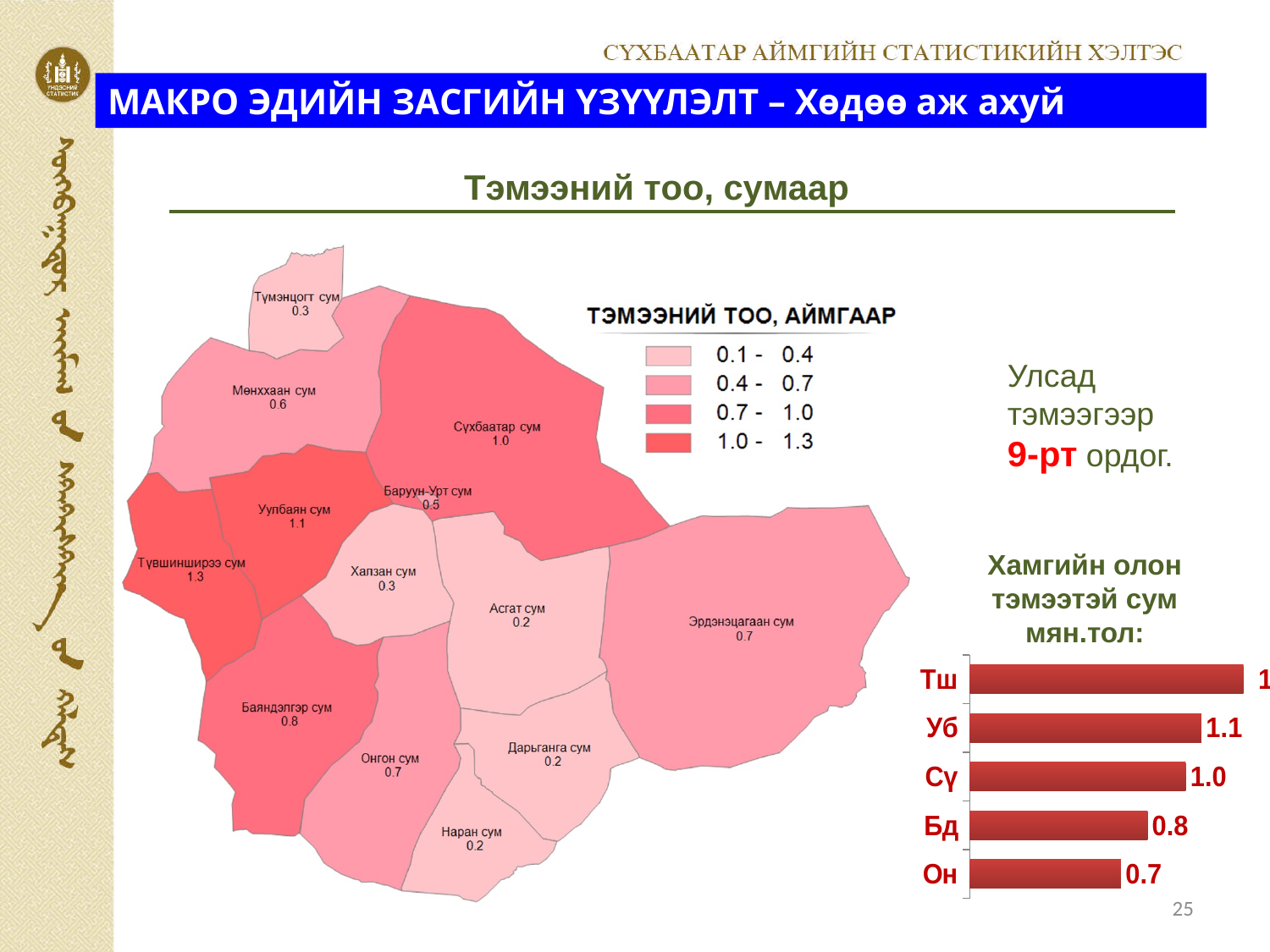
On the map 'Тэмээний тоо, сумаар', what value is printed for Түвшиншир сум? 1.3 In the bar chart 'Хамгийн олон тэмээтэй сум мян.тол:', what is the value for Уб? 1.1 In the bar chart 'Хамгийн олон тэмээтэй сум мян.тол:', what is the difference between the values for Уб and Он? 0.4 On the map 'Тэмээний тоо, сумаар', how many ranges does the legend 'ТЭМЭЭНИЙ ТОО, АЙМГААР' list? 4 In the bar chart 'Хамгийн олон тэмээтэй сум мян.тол:', which is larger, the value for Сү or the value for Бд? Сү In the bar chart 'Хамгийн олон тэмээтэй сум мян.тол:', what is the value for Бд? 0.8 In the bar chart 'Хамгийн олон тэмээтэй сум мян.тол:', what is the value for Он? 0.7 What kind of chart is 'Хамгийн олон тэмээтэй сум мян.тол:'? bar chart In the bar chart 'Хамгийн олон тэмээтэй сум мян.тол:', what is the value for Сү? 1.0 How many categories are shown in the bar chart 'Хамгийн олон тэмээтэй сум мян.тол:'? 5 In the bar chart 'Хамгийн олон тэмээтэй сум мян.тол:', which category has the lowest value? Он In the bar chart 'Хамгийн олон тэмээтэй сум мян.тол:', which category has the longest bar? Тш